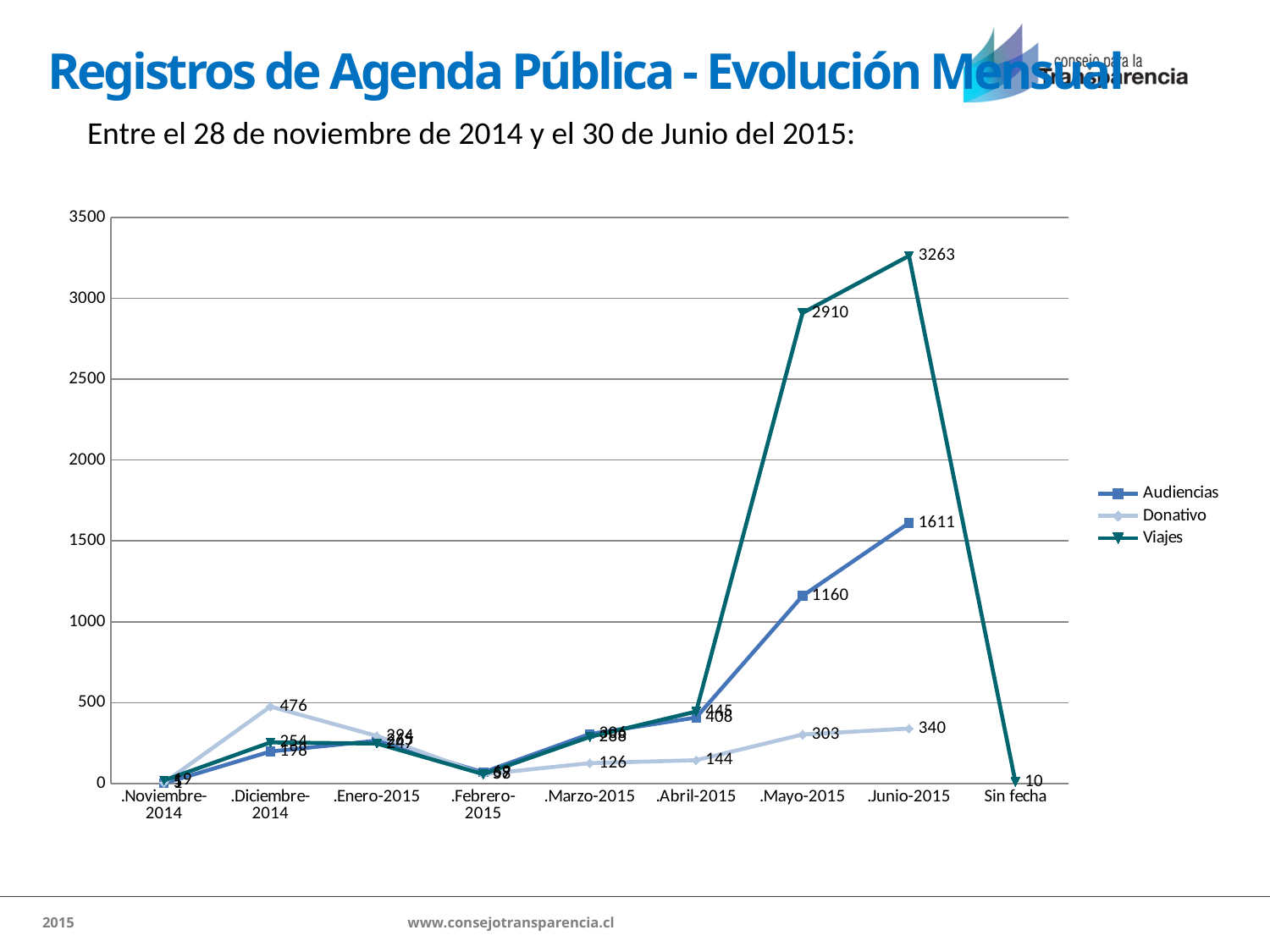
Is the value for Viajes in Junio-2015 greater or less than 3000? greater What is the value for Viajes in Junio-2015? 3263 How many series does the legend list? 3 How many categories are shown along the x axis? 9 Which series are listed in the legend? Audiencias, Donativo, Viajes What kind of chart is shown on the slide? line chart What is the value for Donativo in Diciembre-2014? 476 What is the difference between the Viajes values for Junio-2015 and Mayo-2015? 353 What is the value for Audiencias in Junio-2015? 1611 In Mayo-2015, which is larger: Audiencias or Donativo? Audiencias In which month does Viajes reach its highest value? Junio-2015 What is the value for Viajes in Mayo-2015? 2910